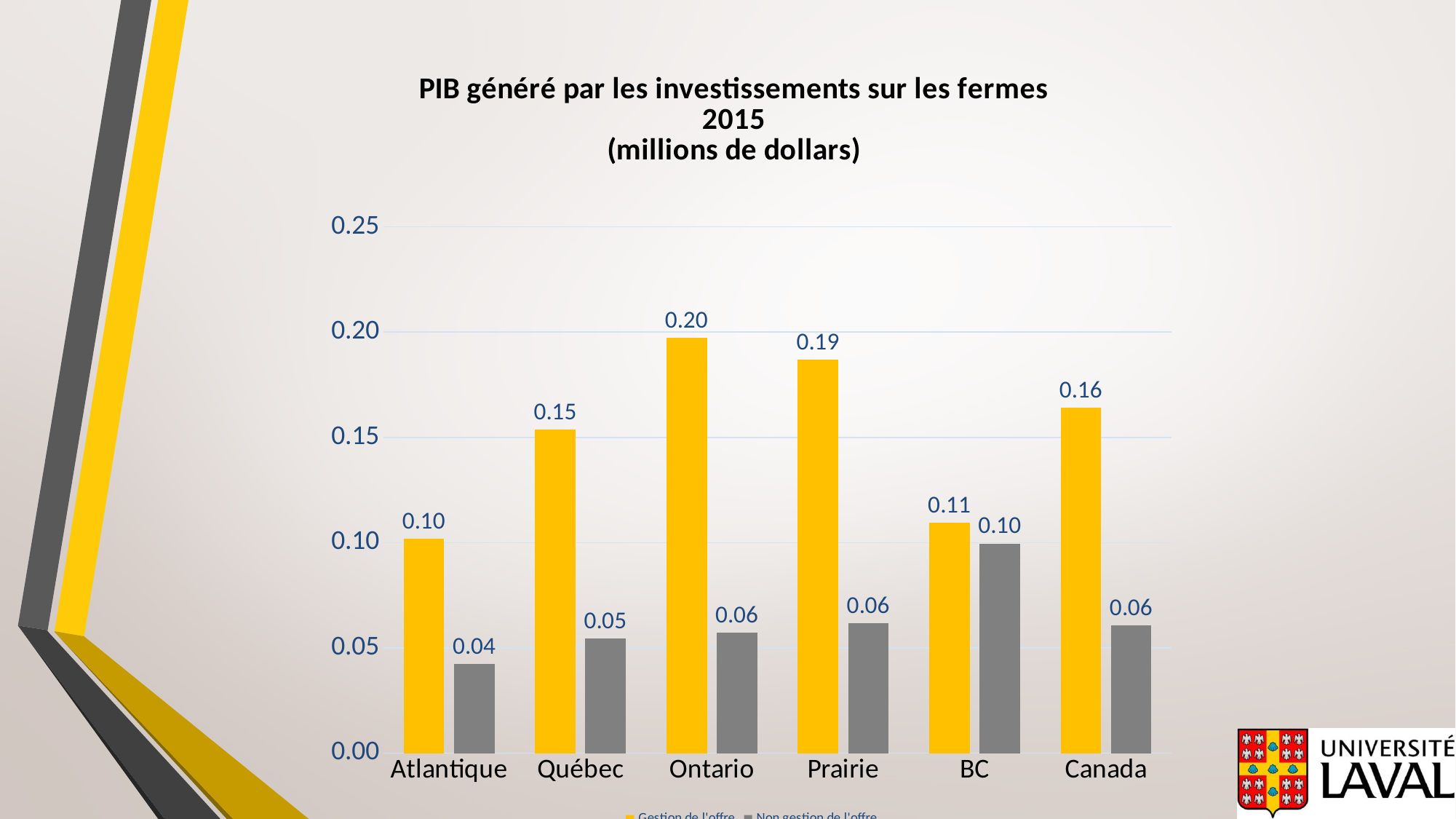
How many series does the chart plot? 2 Which category has the lowest grey bar? Atlantique What is the difference between the yellow and grey bars for Québec? 0.10 Which category has the highest yellow bar? Ontario What is the value of the yellow bar for Canada? 0.16 What is the value of the grey bar for BC? 0.10 How many categories are shown on the x axis? 6 What kind of chart is shown on the slide? bar chart What is the value of the grey bar for Atlantique? 0.04 What is the value of the yellow bar for Ontario? 0.20 What unit is given in the chart title? millions de dollars Which is larger for Prairie, the yellow bar or the grey bar? the yellow bar